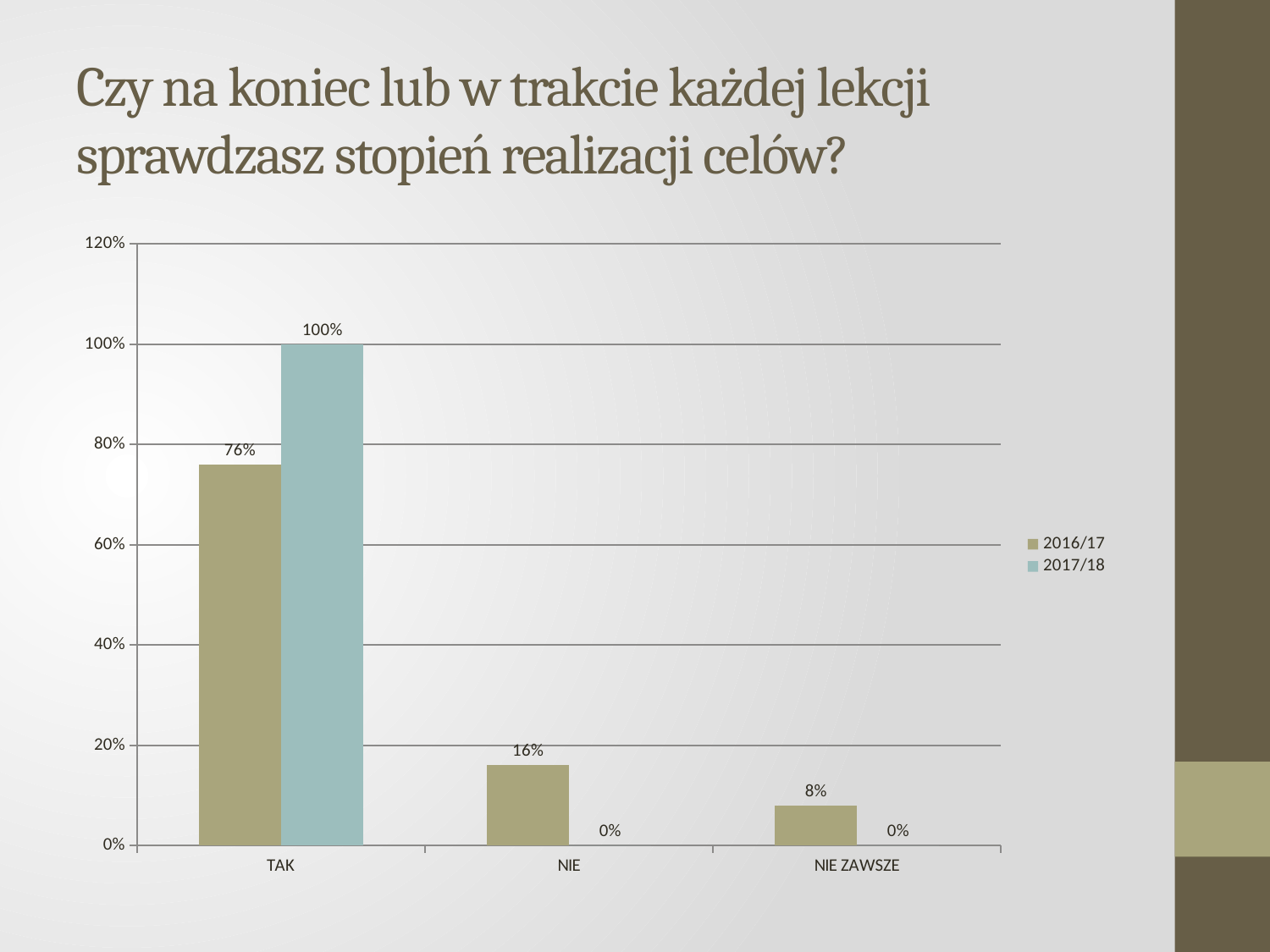
What is the value for TAK in the 2016/17 series? 76% What is the difference between the 2017/18 and 2016/17 values for TAK? 24% What kind of chart is shown on the slide? Bar chart How many series does the legend list? 2 What is the value for NIE ZAWSZE in the 2016/17 series? 8% What is the value for NIE in the 2017/18 series? 0% Which category has the highest value in the 2016/17 series? TAK Which category has the lowest value in the 2016/17 series? NIE ZAWSZE How many categories are shown on the x axis? 3 What is the value for NIE in the 2016/17 series? 16% What is the value for TAK in the 2017/18 series? 100% Which is larger for NIE: the 2016/17 value or the 2017/18 value? 2016/17